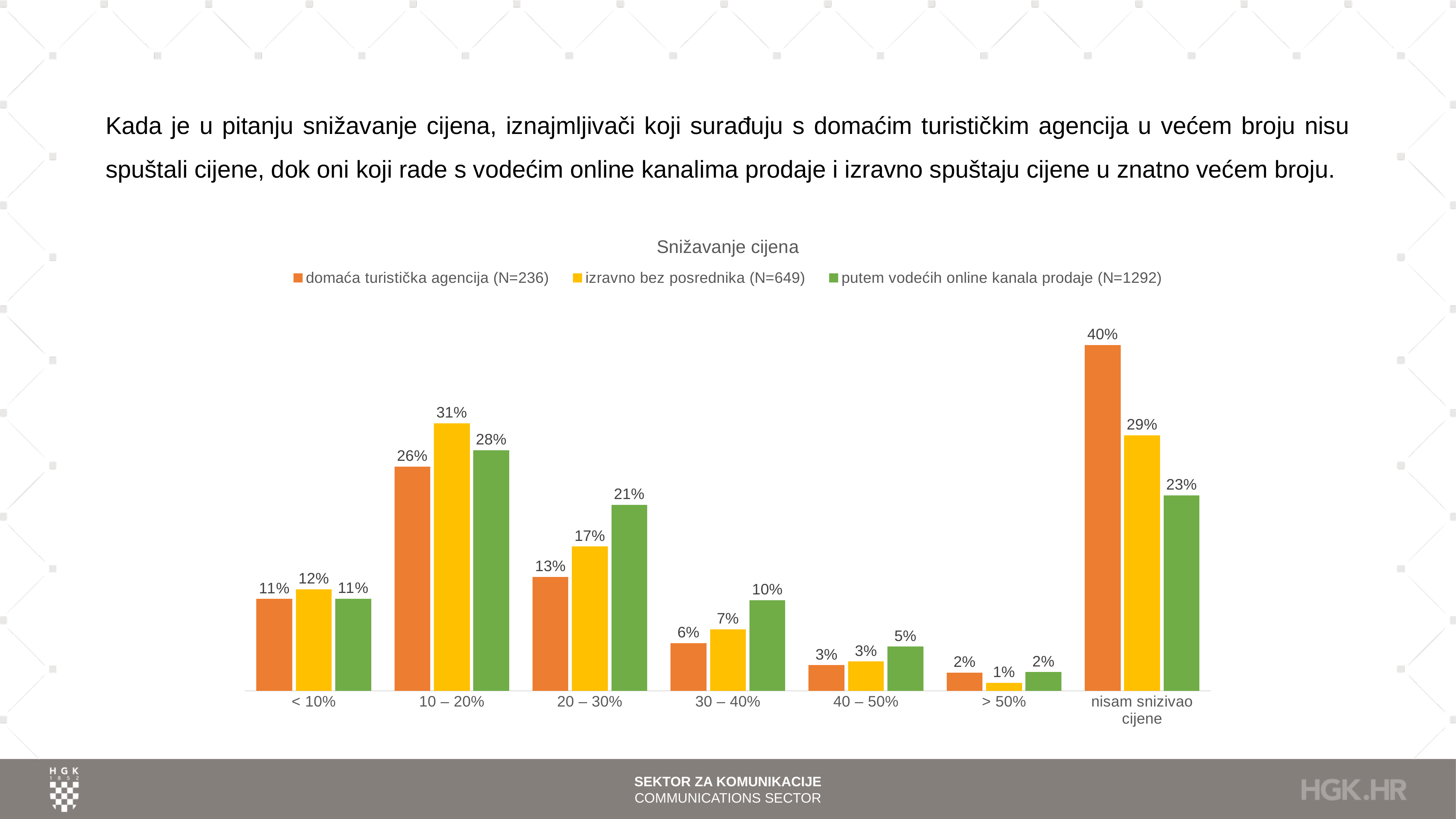
In the '30 – 40%' category, which series has the larger value: 'domaća turistička agencija (N=236)' or 'putem vodećih online kanala prodaje (N=1292)'? putem vodećih online kanala prodaje (N=1292) What is the difference between 'domaća turistička agencija (N=236)' and 'putem vodećih online kanala prodaje (N=1292)' in the 'nisam snizivao cijene' category? 17% Which category has the highest value for 'domaća turistička agencija (N=236)'? nisam snizivao cijene How many series does the legend list? 3 Which category has the lowest value for 'izravno bez posrednika (N=649)'? > 50% What is the value for 'domaća turistička agencija (N=236)' in the 'nisam snizivao cijene' category? 40% What is the title of the chart? Snižavanje cijena What is the value for 'izravno bez posrednika (N=649)' in the '10 – 20%' category? 31% How many categories are shown on the x axis? 7 Which colour represents the series 'izravno bez posrednika (N=649)'? yellow What kind of chart is shown on the slide? bar chart What is the value for 'putem vodećih online kanala prodaje (N=1292)' in the '20 – 30%' category? 21%